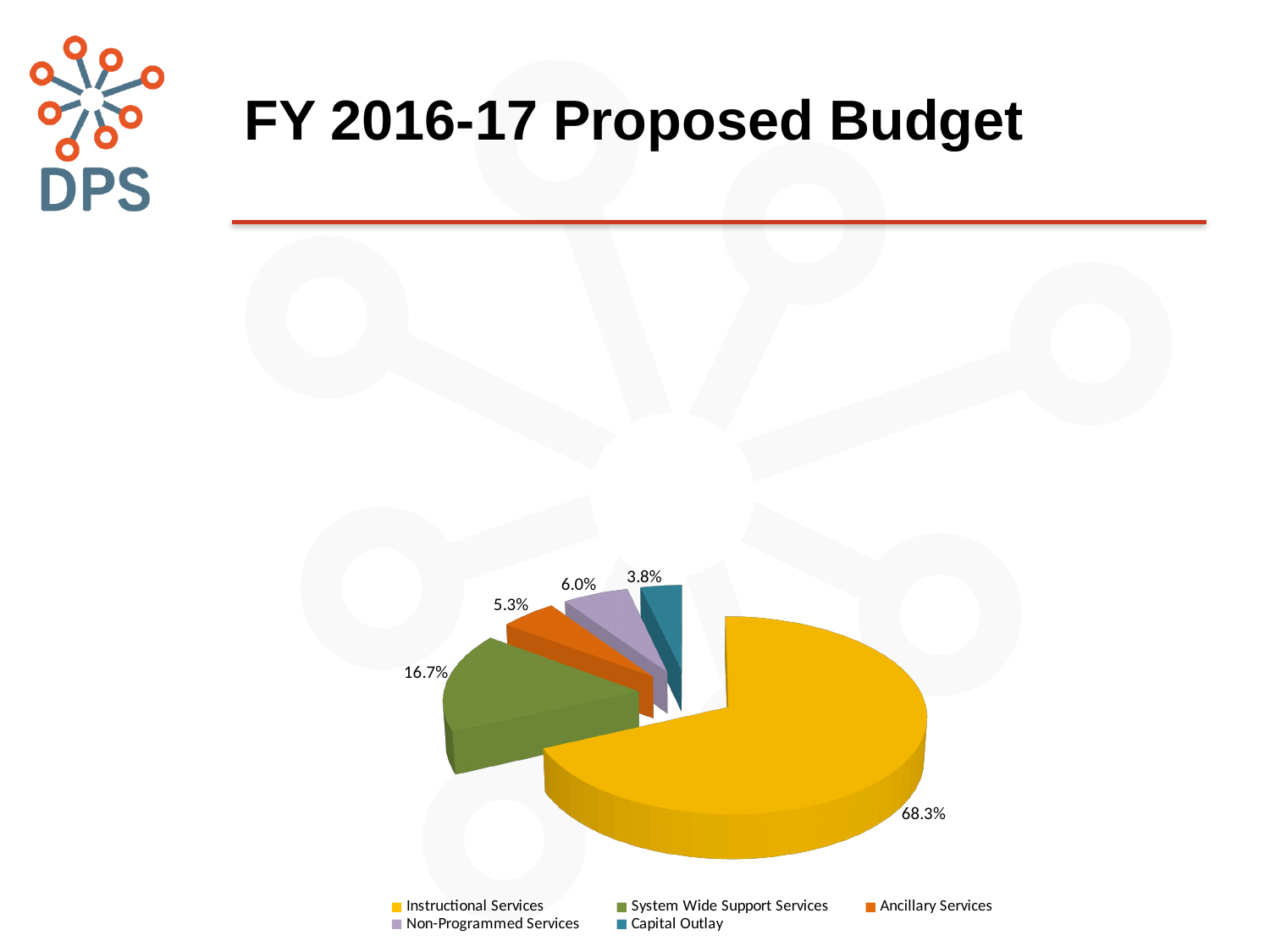
Which is larger, the share for Non-Programmed Services or the share for Ancillary Services? Non-Programmed Services How many categories does the pie chart show? 5 What share of the pie does Non-Programmed Services represent? 6.0% What share of the pie does Instructional Services represent? 68.3% What share of the pie does Ancillary Services represent? 5.3% What kind of chart is shown on the slide? Pie chart What is the title of the slide containing the pie chart? FY 2016-17 Proposed Budget What is the difference in percentage points between Instructional Services and System Wide Support Services? 51.6 Which category has the smallest slice of the pie? Capital Outlay Which category has the largest slice of the pie? Instructional Services